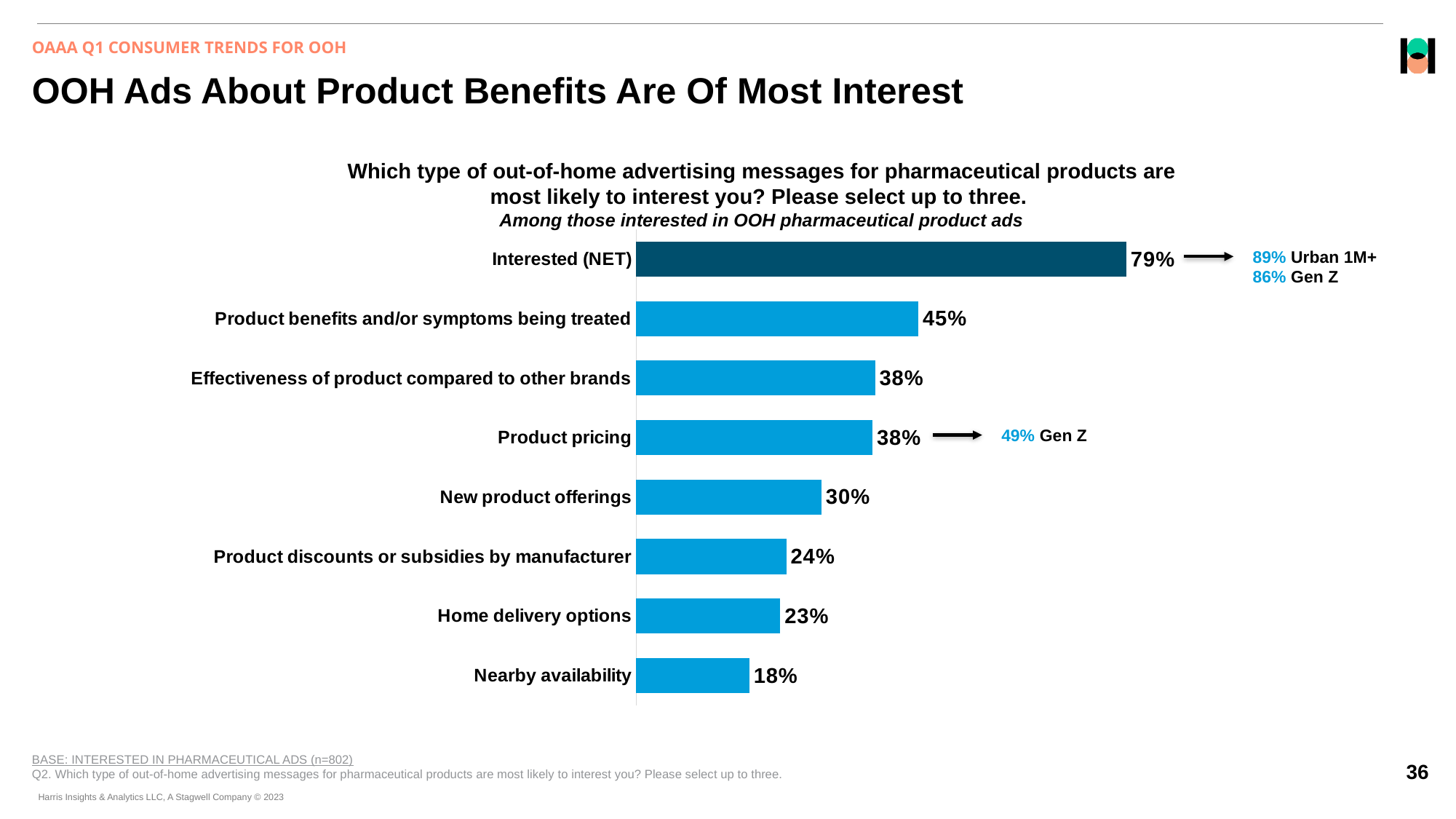
Which category has the lowest value? Nearby availability What is the Urban 1M+ value shown in the callout next to Interested (NET)? 89% How many categories are shown in the chart? 8 What is the Gen Z value shown in the callout next to Product pricing? 49% What is the value for Interested (NET)? 79% What is the value for Home delivery options? 23% What is the value for Product benefits and/or symptoms being treated? 45% Which is larger, Product discounts or subsidies by manufacturer or Nearby availability? Product discounts or subsidies by manufacturer Excluding Interested (NET), which category has the highest value? Product benefits and/or symptoms being treated What is the value for New product offerings? 30% What is the difference between Product benefits and/or symptoms being treated and Product pricing? 7% What kind of chart is shown on the slide? Bar chart